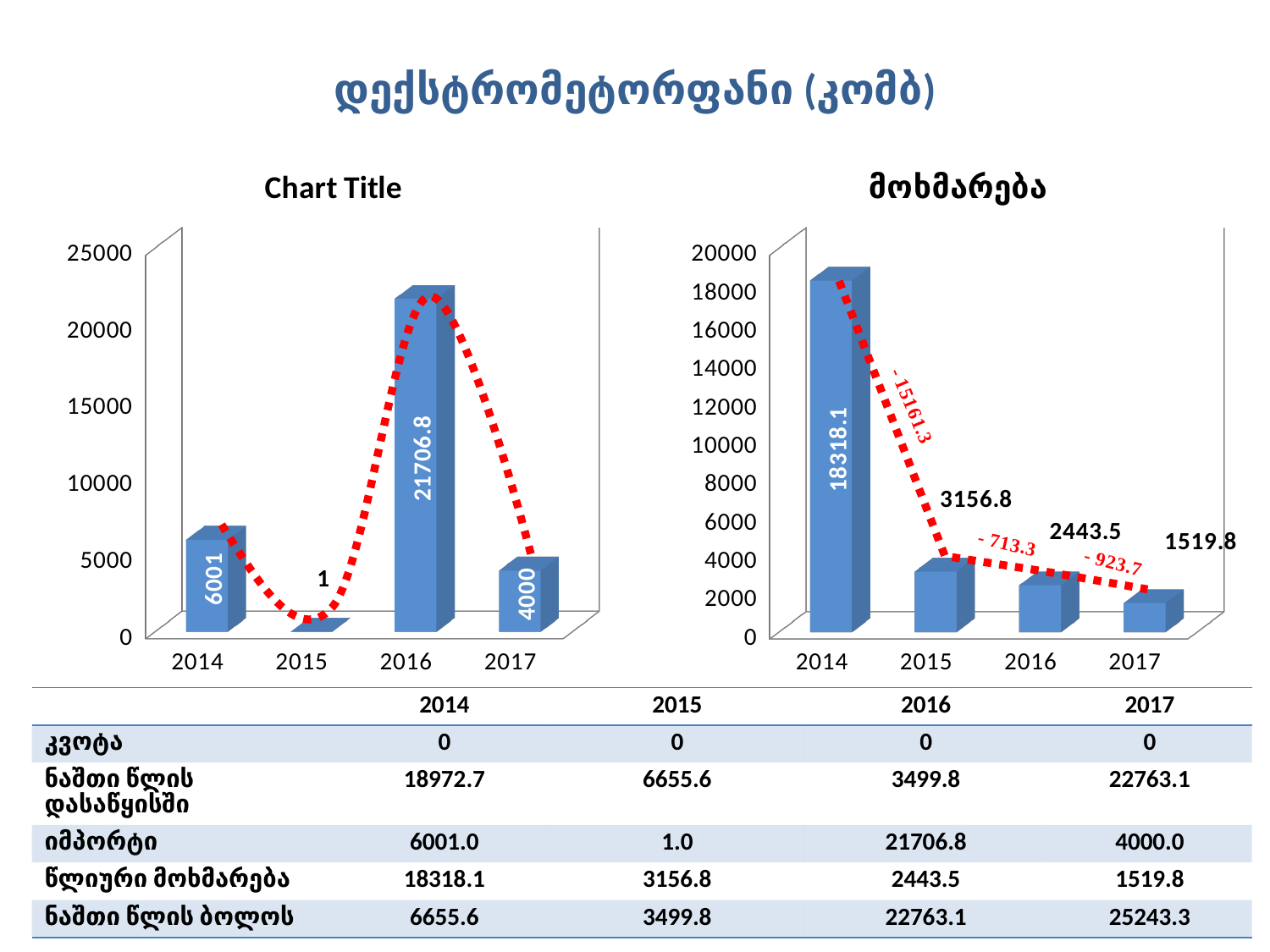
What kind of chart is the chart titled "მოხმარება"? bar chart In the chart titled "მოხმარება", which year has the highest value? 2014 In the chart titled "Chart Title", what is the difference between the values for 2016 and 2017? 17706.8 In the chart titled "Chart Title", what is the value for 2014? 6001 In the chart titled "მოხმარება", do the values rise or fall from 2014 to 2017? fall In the chart titled "Chart Title", what is the value for 2016? 21706.8 In the chart titled "მოხმარება", what is the value for 2014? 18318.1 In the chart titled "მოხმარება", how many years are shown on the x axis? 4 In the chart titled "Chart Title", which year has the highest value? 2016 In the chart titled "მოხმარება", what is the difference between the values for 2015 and 2016? 713.3 In the chart titled "Chart Title", which year has the lowest value? 2015 In the chart titled "მოხმარება", what is the value for 2017? 1519.8